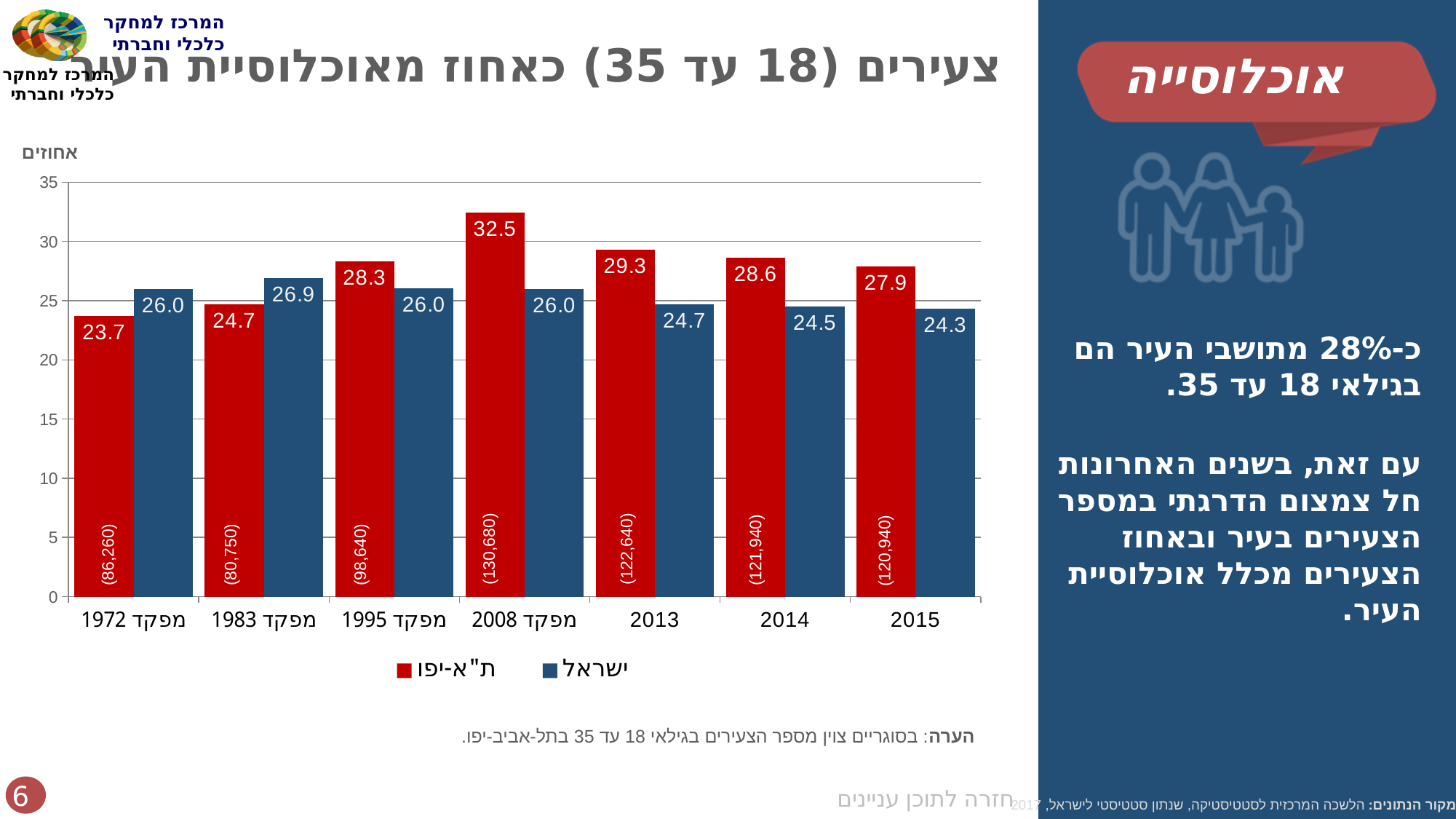
What kind of chart is shown on the slide? bar chart What is the value for ישראל in 2015? 24.3 Is the ת"א-יפו value for 2013 greater or less than 25? greater How many series does the legend list? 2 What is the difference between the ת"א-יפו and ישראל values in מפקד 2008? 6.5 What is the value for ת"א-יפו in מפקד 2008? 32.5 What number is printed in parentheses inside the ת"א-יפו bar for 2014? (121,940) What is the value for ת"א-יפו in מפקד 1972? 23.7 In which category is the ישראל value lowest? 2015 Which is larger in מפקד 1983: the ת"א-יפו value or the ישראל value? ישראל In which category is the ת"א-יפו value highest? מפקד 2008 How many categories are shown on the x axis? 7